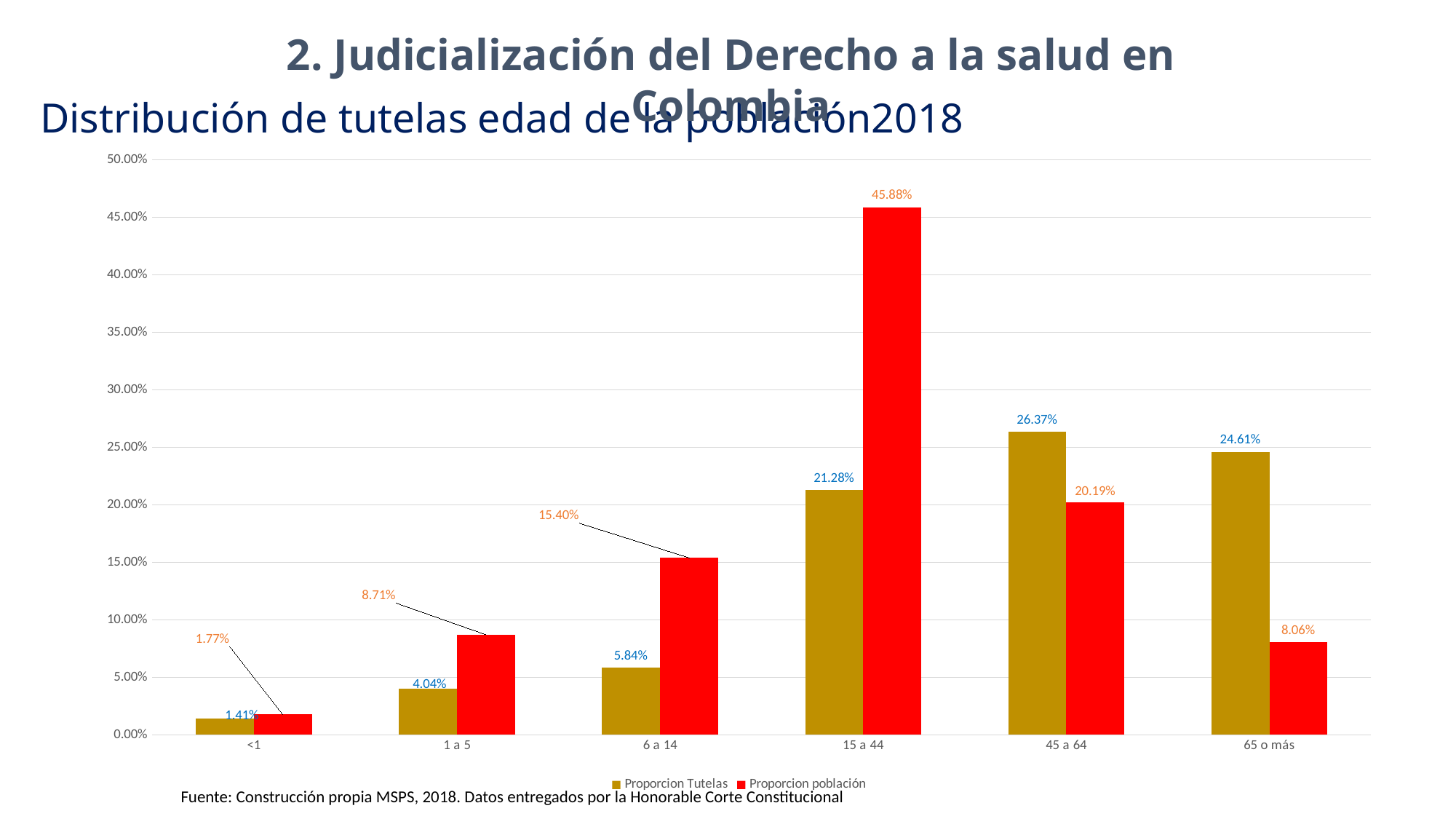
Which age group has the lowest Proporcion población value? <1 What is the difference between Proporcion población and Proporcion Tutelas for the 15 a 44 age group? 24.60% What kind of chart is shown on the slide? Bar chart Is the Proporcion población value for 45 a 64 greater or less than 25.00%? less For the 65 o más age group, which is larger: Proporcion Tutelas or Proporcion población? Proporcion Tutelas Which age group has the highest Proporcion Tutelas value? 45 a 64 What is the Proporcion Tutelas value for the 45 a 64 age group? 26.37% Which series is shown in red in the legend? Proporcion población How many series does the legend list? 2 How many age groups are shown on the x axis? 6 What is the Proporcion población value for the 6 a 14 age group? 15.40% What is the Proporcion población value for the 15 a 44 age group? 45.88%